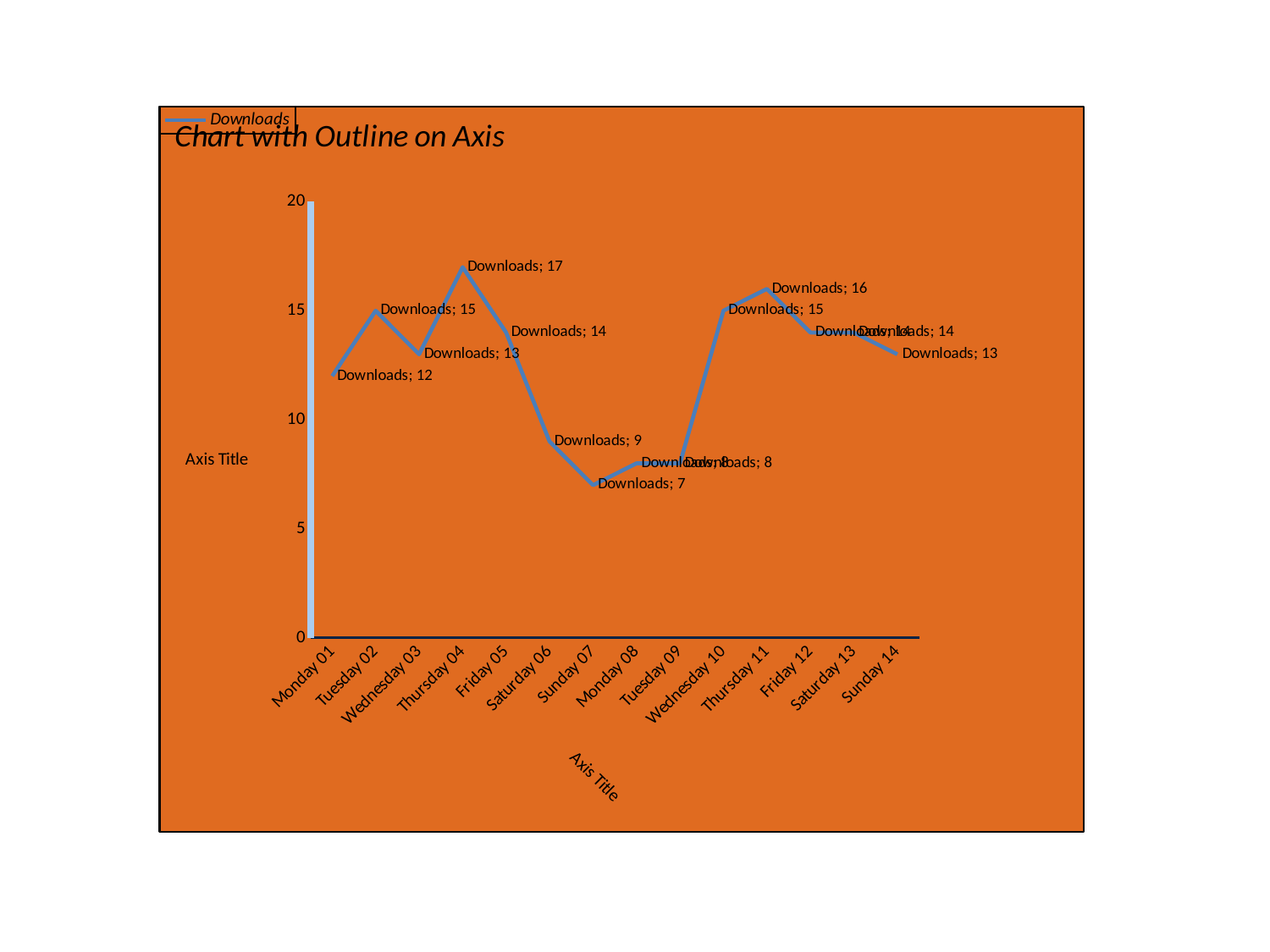
How many days are plotted on the x axis? 14 Which day has the highest Downloads value? Thursday 04 What is the Downloads value for Saturday 06? 9 Which day has the lowest Downloads value? Sunday 07 What is the Downloads value for Thursday 11? 16 What is the Downloads value for Sunday 07? 7 What is the Downloads value for Thursday 04? 17 Which has a higher Downloads value, Tuesday 02 or Wednesday 03? Tuesday 02 What is the difference between the Downloads values for Thursday 04 and Sunday 07? 10 What is the title of the chart? Chart with Outline on Axis What kind of chart is shown on the slide? Line chart What is the Downloads value for Monday 01? 12